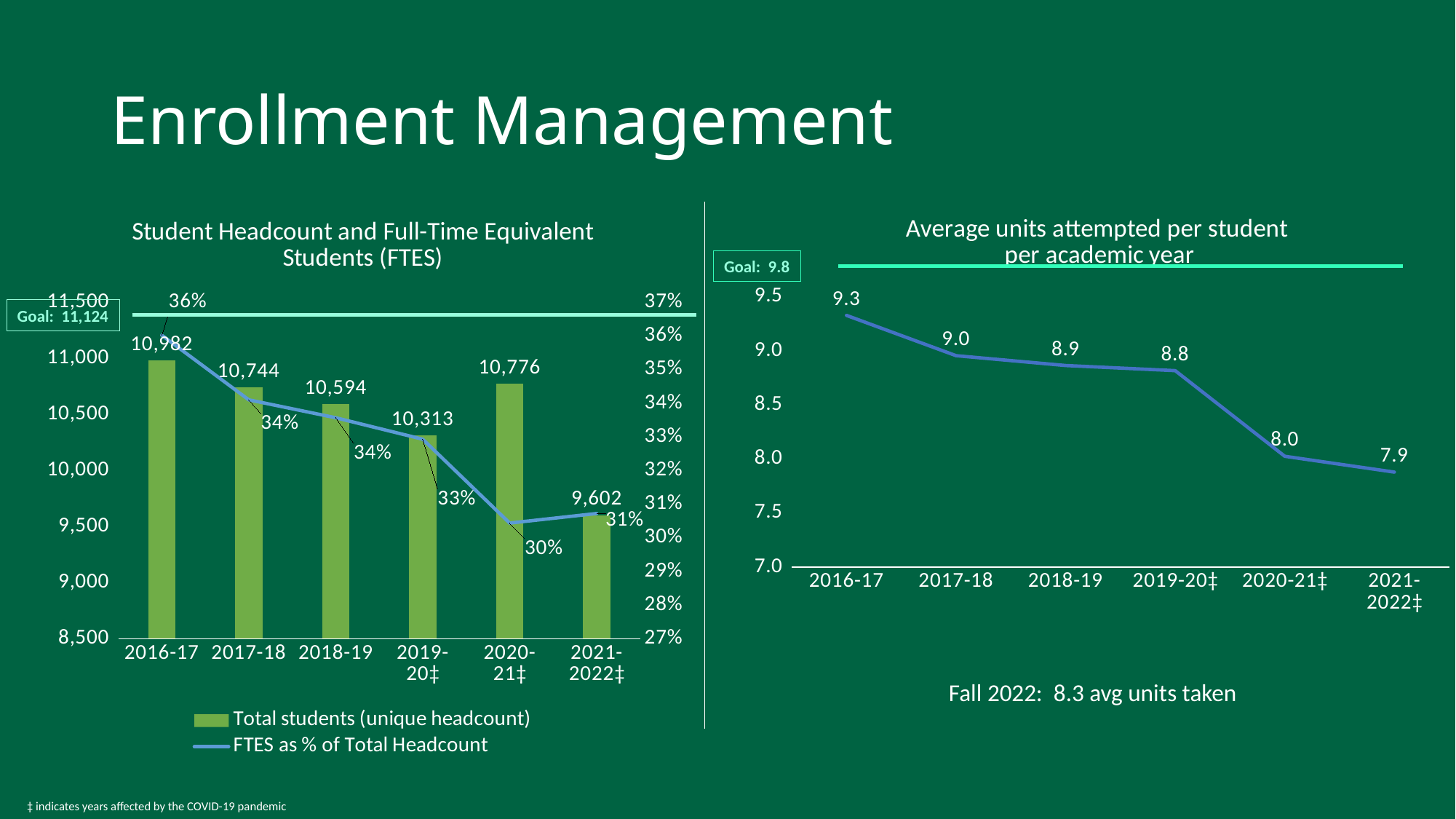
In the 'Student Headcount and Full-Time Equivalent Students (FTES)' chart, which is larger, the headcount for 2017-18 or for 2020-21‡? 2020-21‡ What goal value is shown on the 'Student Headcount and Full-Time Equivalent Students (FTES)' chart? 11,124 In the 'Student Headcount and Full-Time Equivalent Students (FTES)' chart, what is the difference in headcount between 2020-21‡ and 2021-2022‡? 1,174 In the 'Average units attempted per student per academic year' chart, what is the difference between the 2016-17 and 2021-2022‡ values? 1.4 In the 'Student Headcount and Full-Time Equivalent Students (FTES)' chart, what is the total student headcount for 2016-17? 10,982 In the 'Student Headcount and Full-Time Equivalent Students (FTES)' chart, which year has the lowest total student headcount? 2021-2022‡ In the 'Student Headcount and Full-Time Equivalent Students (FTES)' chart, what is FTES as % of Total Headcount for 2020-21‡? 30% In the 'Average units attempted per student per academic year' chart, do the values rise or fall from 2016-17 to 2021-2022‡? Fall How many series does the legend of the 'Student Headcount and Full-Time Equivalent Students (FTES)' chart list? 2 In the 'Average units attempted per student per academic year' chart, what is the value for 2018-19? 8.9 What type of chart is the 'Average units attempted per student per academic year' chart? Line chart In the 'Average units attempted per student per academic year' chart, which year has the highest value? 2016-17